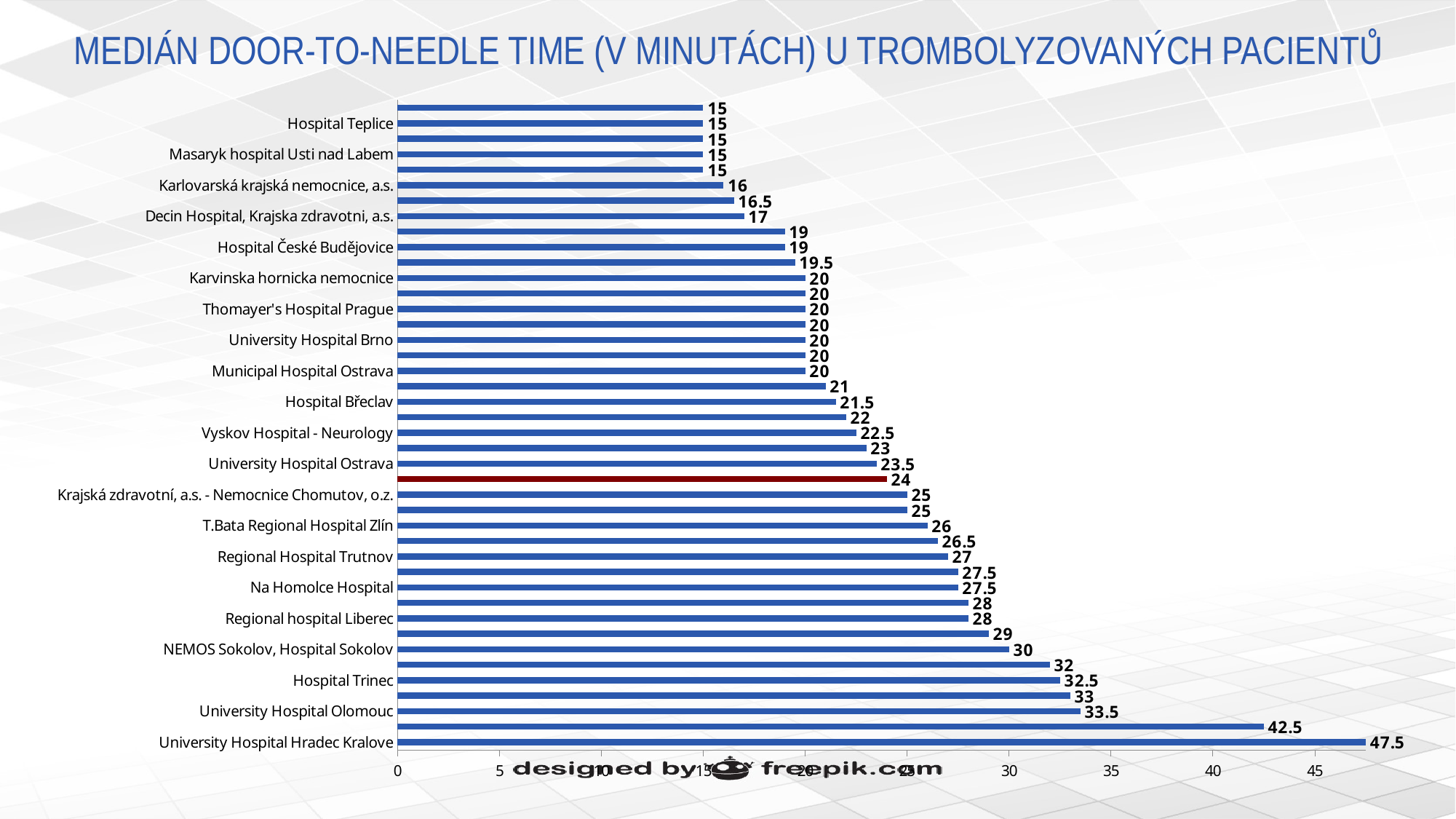
Which hospital has the highest median door-to-needle time? University Hospital Hradec Kralove Do the bar values increase or decrease going from the top of the chart to the bottom? Increase What is the median door-to-needle time for Hospital Trinec? 32.5 What value is labelled on the single red bar in the chart? 24 What is the value shown for Hospital Břeclav? 21.5 Is the value for NEMOS Sokolov, Hospital Sokolov greater or less than 25? greater What is the difference between the values for University Hospital Hradec Kralove and University Hospital Olomouc? 14 What is the value shown for Na Homolce Hospital? 27.5 Which has a higher value, Hospital Trinec or Regional hospital Liberec? Hospital Trinec What is the median door-to-needle time for University Hospital Hradec Kralove? 47.5 What kind of chart is shown on the slide? Bar chart What is the lowest median door-to-needle time shown on the chart? 15